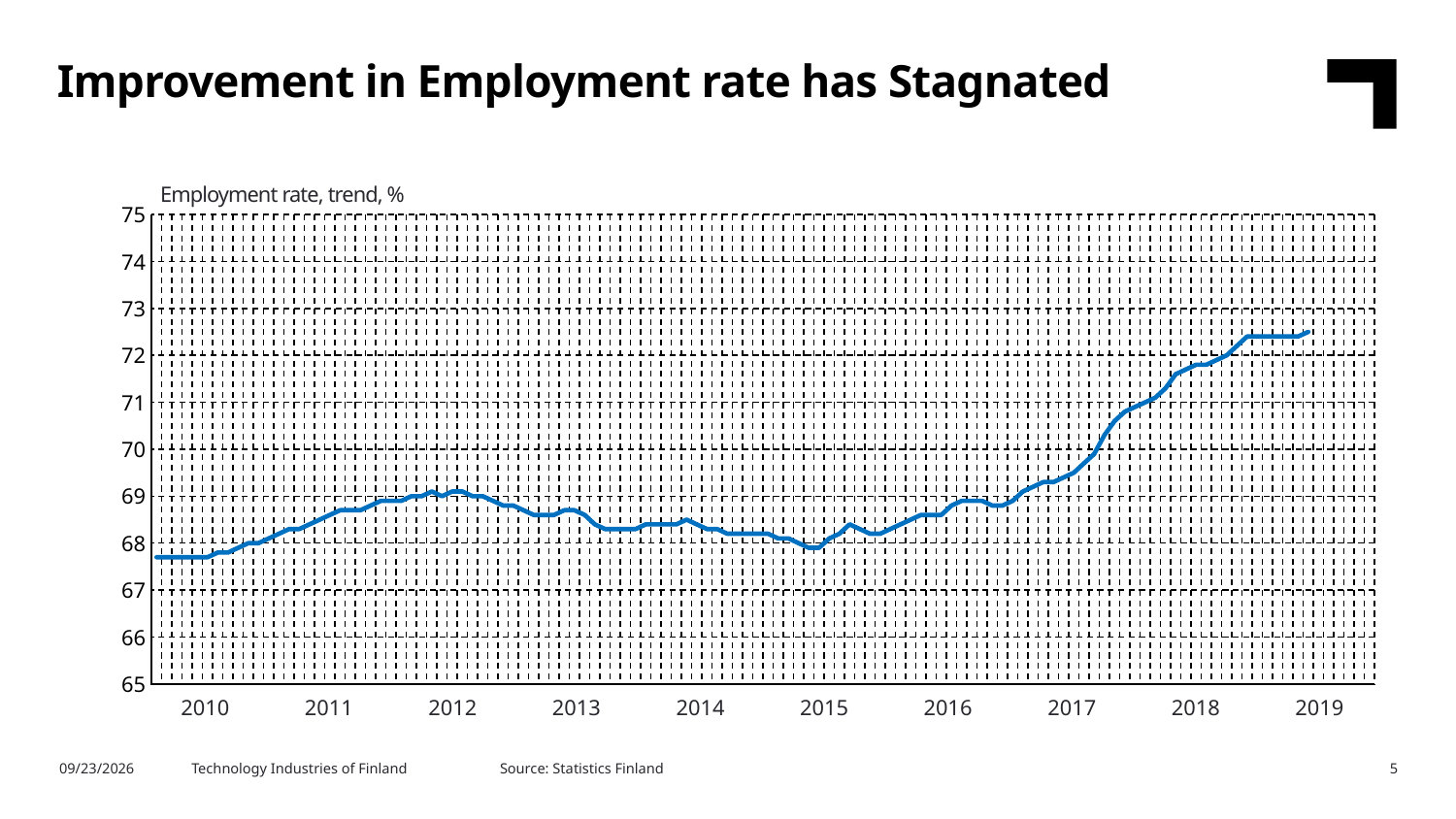
Does the employment rate rise or fall between 2012 and 2015? fall What is the title of the chart? Employment rate, trend, % Is the employment rate at the start of 2017 greater or less than 70? less What kind of chart is shown on the slide? line chart Is the employment rate at the start of 2010 greater or less than 68? less Is the employment rate at the start of 2012 greater or less than 70? less In which year does the employment rate reach its highest level? 2019 How many year labels are shown on the x axis? 10 Does the employment rate rise or fall between 2017 and 2019? rise